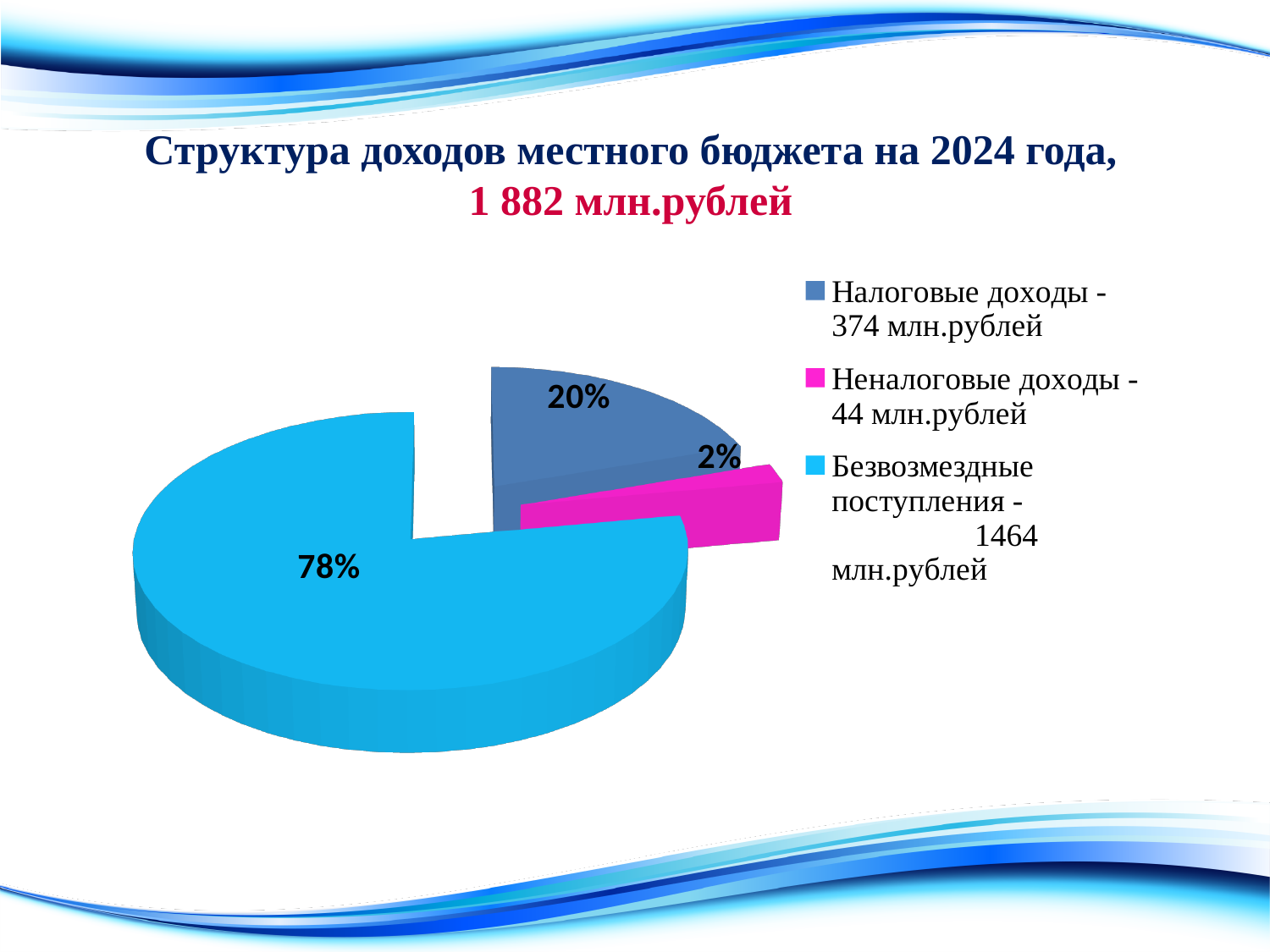
Which is larger: the share for Налоговые доходы or the share for Неналоговые доходы? Налоговые доходы What share of the pie does Безвозмездные поступления take? 78% How many slices does the pie chart have? 3 How many entries does the legend list? 3 Which category has the largest slice of the pie? Безвозмездные поступления What kind of chart is shown on the slide? Pie chart Which category has the smallest slice of the pie? Неналоговые доходы What share of the pie does Налоговые доходы take? 20% What total amount is stated in the chart title? 1 882 млн.рублей What is the difference in percentage points between the Безвозмездные поступления slice and the Налоговые доходы slice? 58 What share of the pie does Неналоговые доходы take? 2% According to the legend, what amount in млн.рублей corresponds to Налоговые доходы? 374 млн.рублей